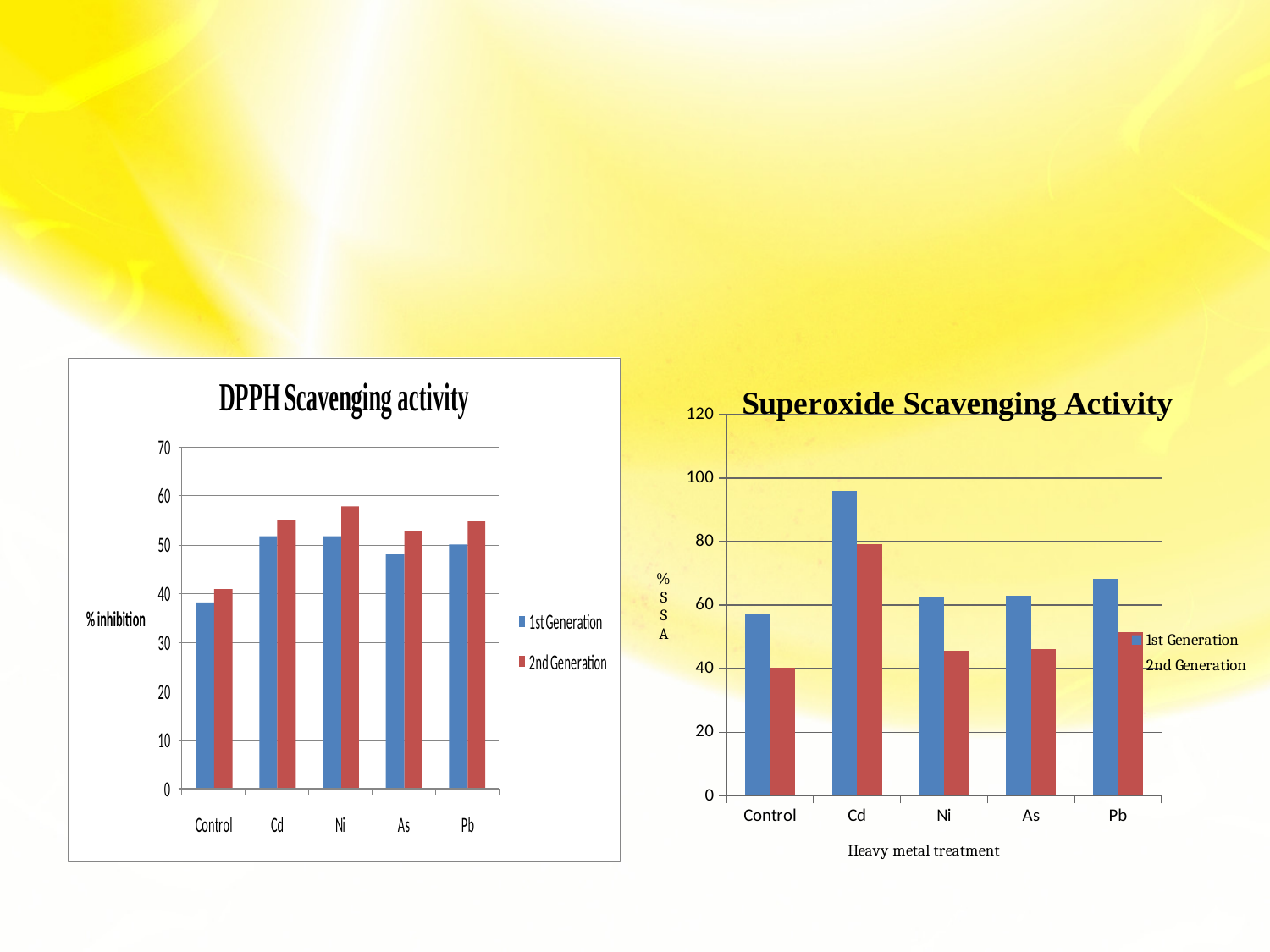
In the Superoxide Scavenging Activity chart, is the 2nd Generation value for Control greater or less than 60? less In the DPPH Scavenging activity chart, which category has the highest 2nd Generation value? Ni How many series does the legend of the Superoxide Scavenging Activity chart list? 2 In the Superoxide Scavenging Activity chart, which series has the larger value for Control, 1st Generation or 2nd Generation? 1st Generation In the DPPH Scavenging activity chart, is the 2nd Generation value for Ni greater or less than 50? greater How many categories are shown on the x axis of the DPPH Scavenging activity chart? 5 In the DPPH Scavenging activity chart, is the 1st Generation value for Control greater or less than 40? less In the DPPH Scavenging activity chart, which category has the lowest 1st Generation value? Control In the Superoxide Scavenging Activity chart, which category has the lowest 2nd Generation value? Control What kind of chart is the Superoxide Scavenging Activity chart? bar chart In the Superoxide Scavenging Activity chart, which category has the highest 1st Generation value? Cd